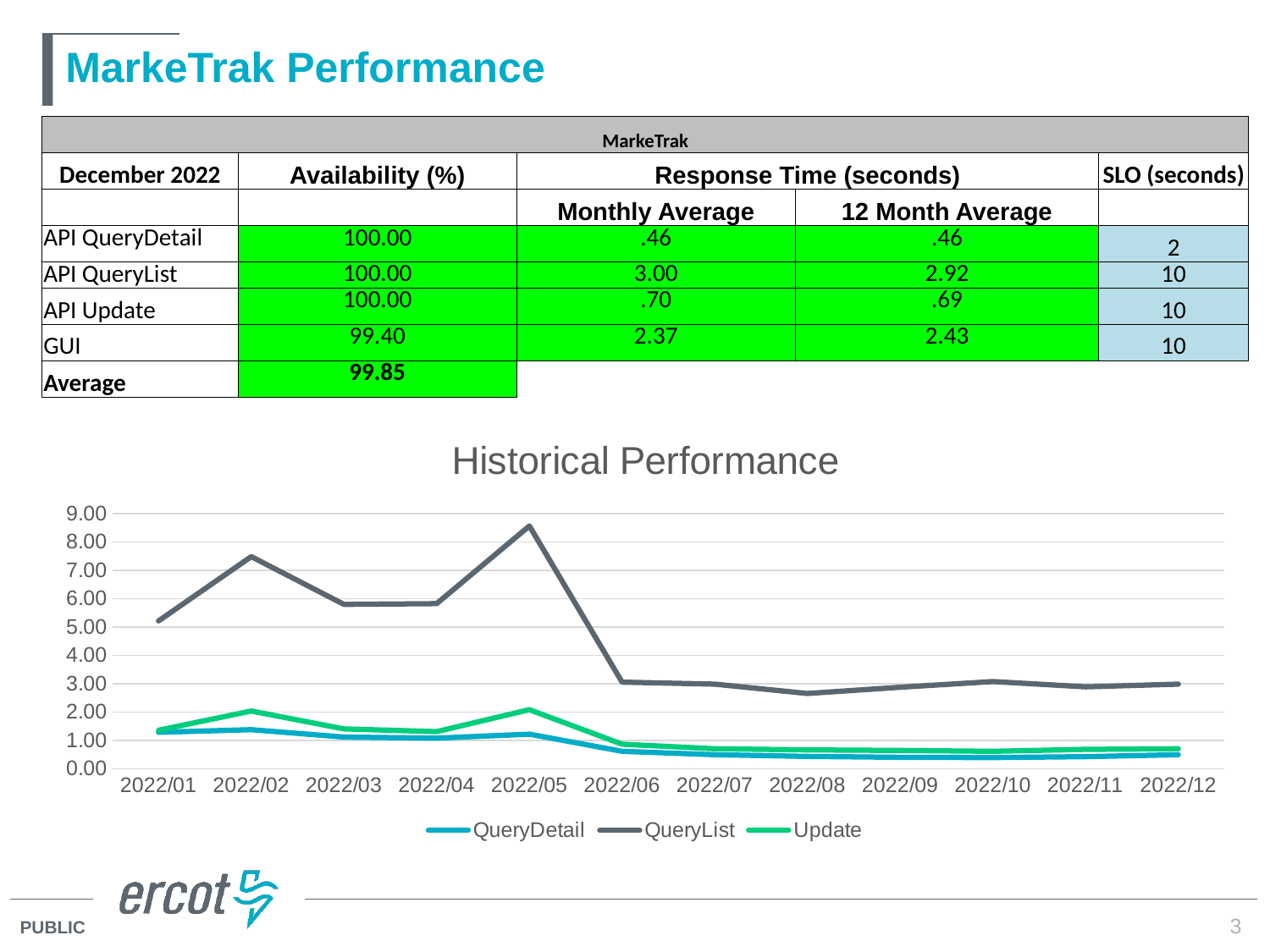
How many months are shown on the x axis of the Historical Performance chart? 12 In the Historical Performance chart, is the Update value for 2022/02 greater or less than 1.00? greater How many series does the legend of the Historical Performance chart list? 3 In the Historical Performance chart, is the QueryList value for 2022/05 greater or less than 8.00? greater In the Historical Performance chart, is the QueryList value for 2022/08 greater or less than 3.00? less In the Historical Performance chart, in which month does the QueryList series reach its peak? 2022/05 In the Historical Performance chart, does the QueryList series rise or fall between 2022/05 and 2022/06? fall In the Historical Performance chart, which series has the highest values across the months? QueryList In the Historical Performance chart, which is larger at 2022/05: QueryList or Update? QueryList What is the title of the line chart on the slide? Historical Performance What kind of chart is the Historical Performance chart? line chart